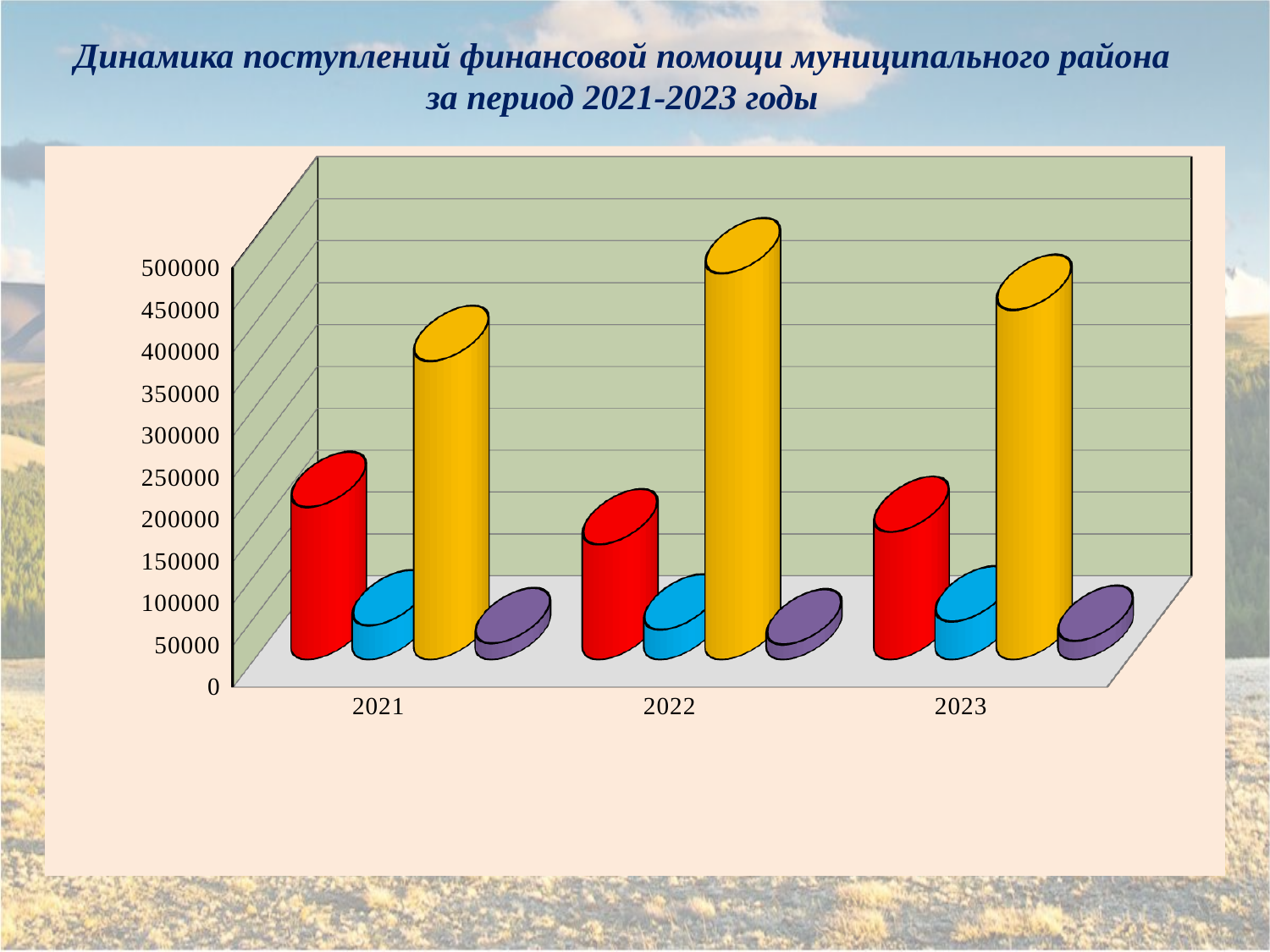
What kind of chart is shown on the slide? bar chart What period does the chart title say the data covers? 2021-2023 годы Which is larger, the red bar for 2021 or the red bar for 2022? the red bar for 2021 Is the yellow bar for 2022 greater or less than 400000? greater Is the purple bar for 2021 greater or less than 100000? less Which colour bar is the lowest in every year shown? purple How many bars are plotted for each year in the chart? 4 Is the blue bar for 2023 greater or less than 200000? less How many years are shown on the x axis of the chart? 3 Which year has the tallest yellow bar? 2022 Which colour bar is the highest in every year shown? yellow